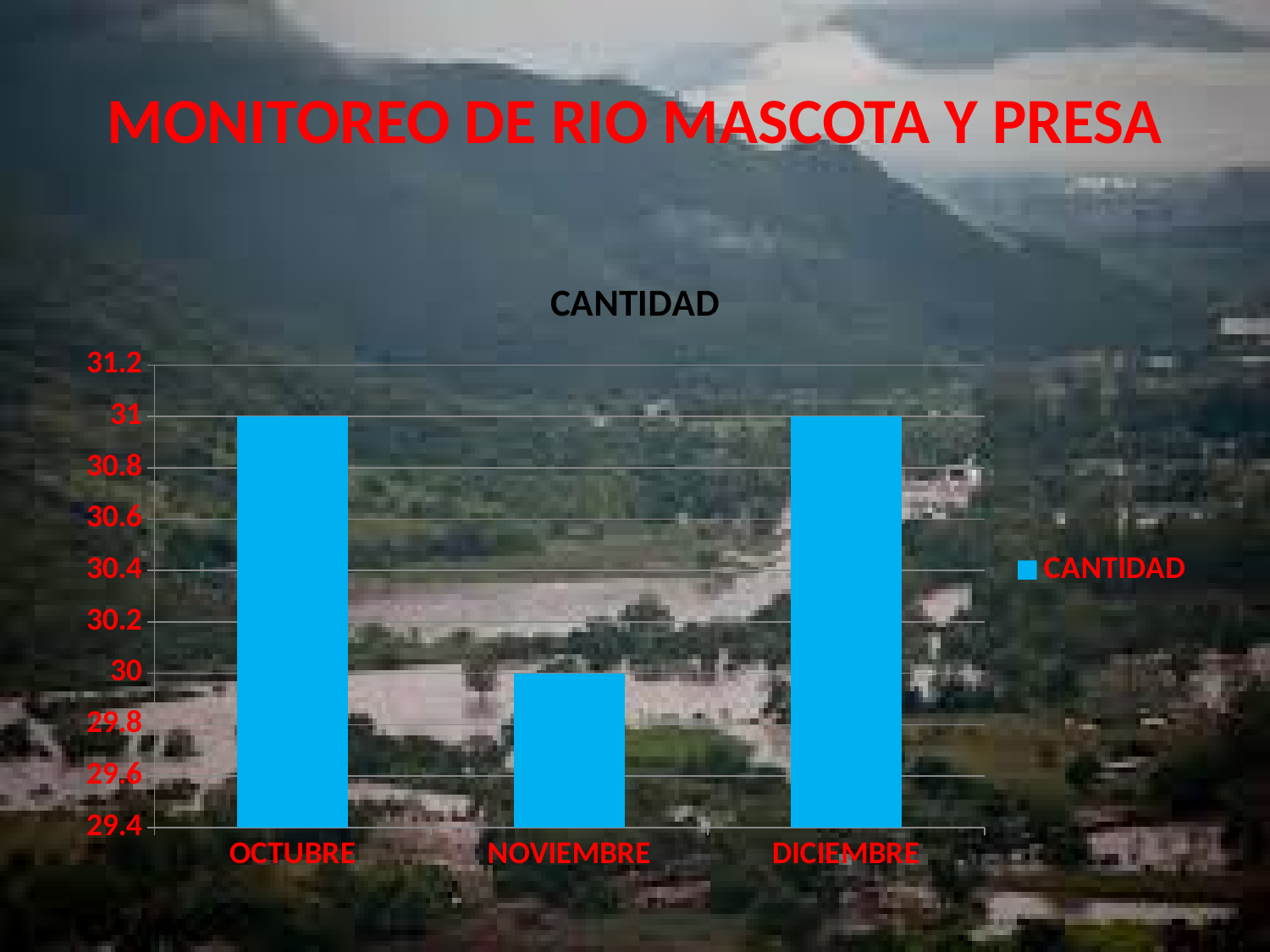
Is the value for OCTUBRE greater or less than 30.6? greater What is the difference between the values for OCTUBRE and NOVIEMBRE? 1 What is the value for DICIEMBRE? 31 What kind of chart is shown? bar chart What is the value for OCTUBRE? 31 How many series does the legend list? 1 How many categories are shown on the x axis? 3 Which is larger, the value for NOVIEMBRE or the value for DICIEMBRE? DICIEMBRE Which month has the lowest value? NOVIEMBRE Is the value for NOVIEMBRE greater or less than 30.4? less What is the title of the chart? CANTIDAD What is the value for NOVIEMBRE? 30